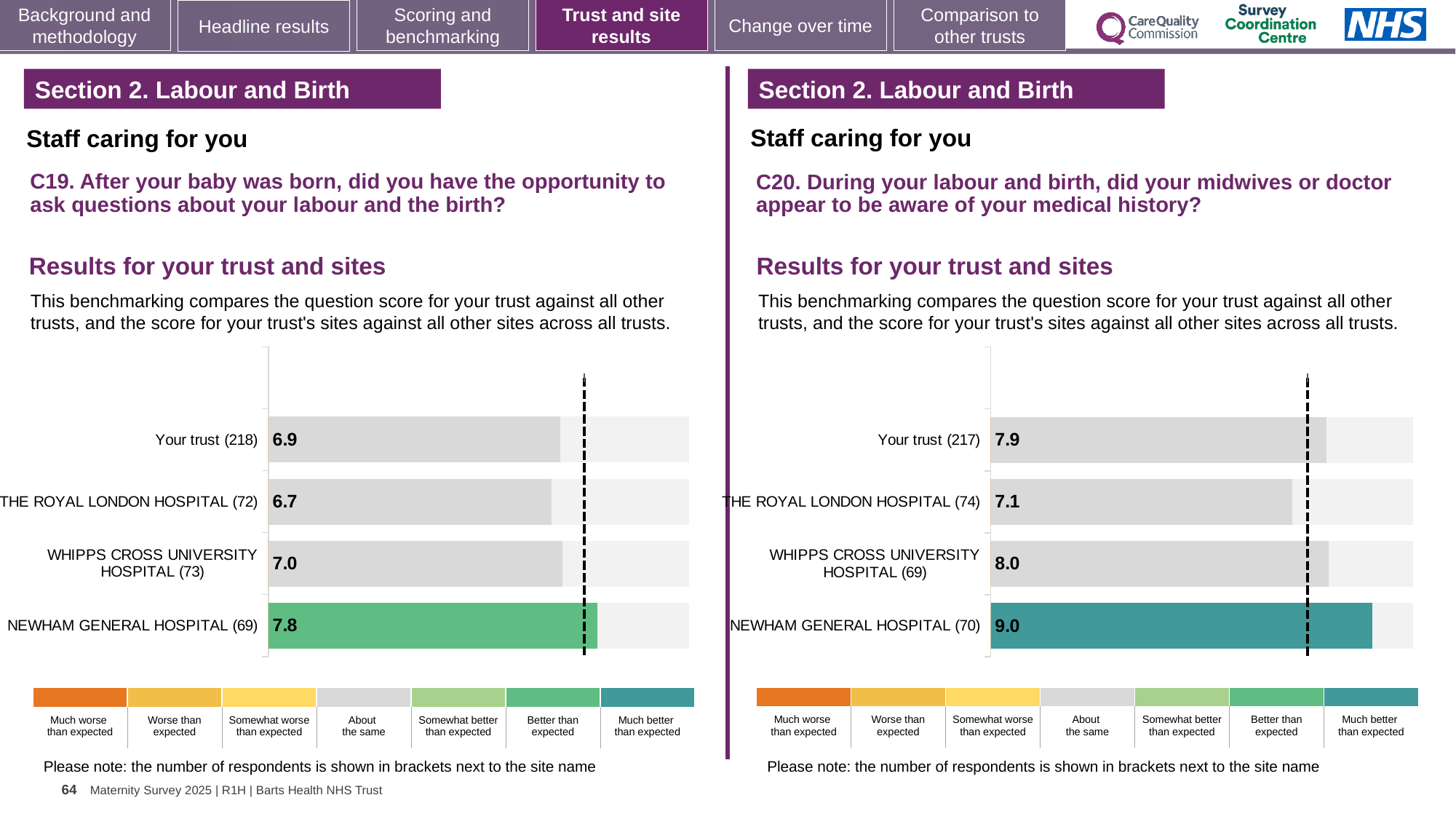
On the C20 chart (right), what is the difference between the scores for NEWHAM GENERAL HOSPITAL (70) and Your trust (217)? 1.1 On the C20 chart (right), what is the score for THE ROYAL LONDON HOSPITAL (74)? 7.1 On the C19 chart (left), what is the score for Your trust (218)? 6.9 What kind of chart is used on the C19 chart (left)? Bar chart On the C19 chart (left), which site or trust has the lowest score? THE ROYAL LONDON HOSPITAL (72) On the C19 chart (left), what is the score for NEWHAM GENERAL HOSPITAL (69)? 7.8 On the C20 chart (right), which is larger: the score for Your trust (217) or for THE ROYAL LONDON HOSPITAL (74)? Your trust (217) On the C20 chart (right), what is the score for WHIPPS CROSS UNIVERSITY HOSPITAL (69)? 8.0 On the C19 chart (left), how many bars are plotted? 4 On the C19 chart (left), what is the difference between the scores for NEWHAM GENERAL HOSPITAL (69) and THE ROYAL LONDON HOSPITAL (72)? 1.1 On the C20 chart (right), which site or trust has the highest score? NEWHAM GENERAL HOSPITAL (70) On the C20 chart (right), which benchmarking category does the colour of the NEWHAM GENERAL HOSPITAL (70) bar correspond to in the legend? Much better than expected